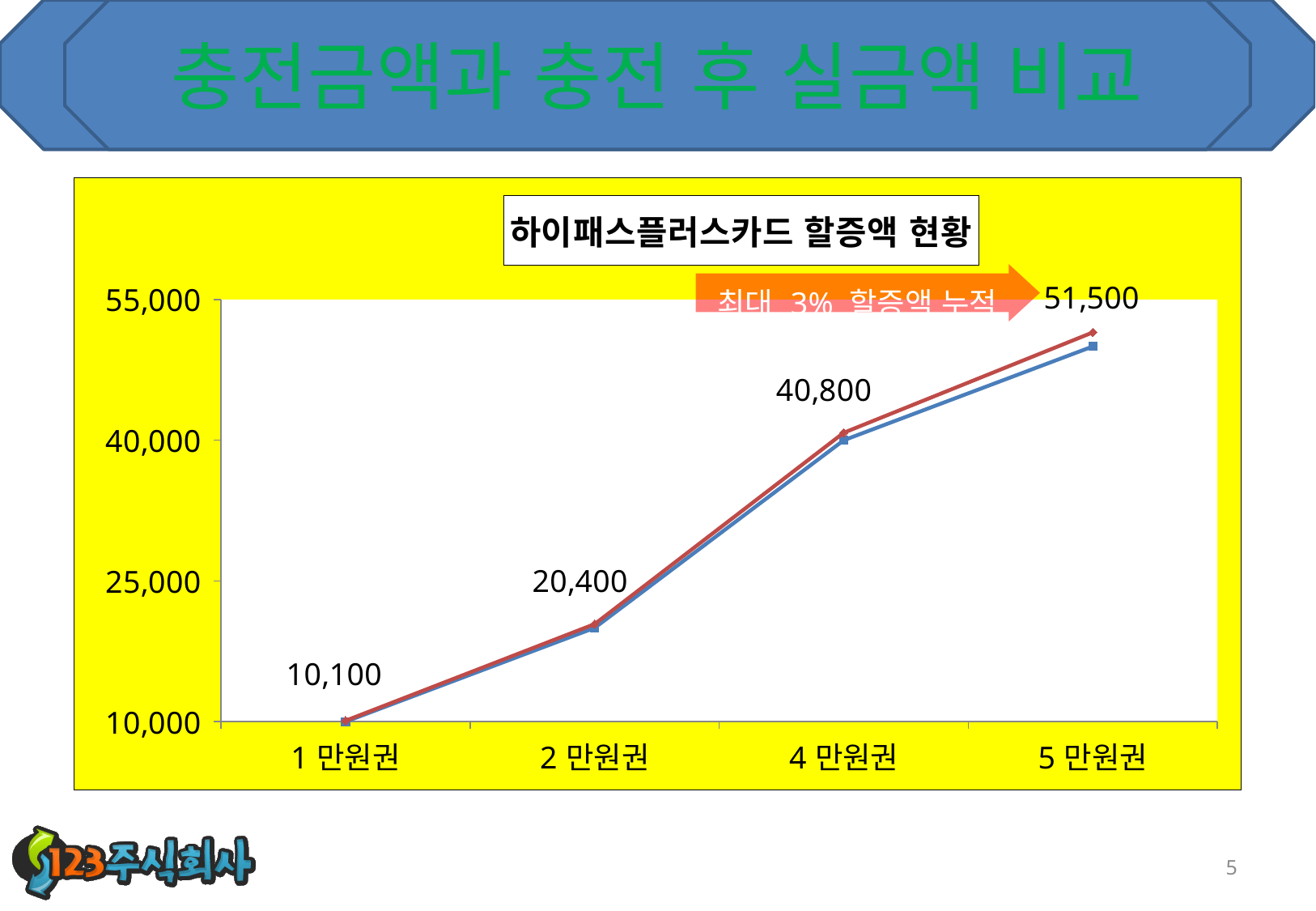
What value is labelled at 4 만원권 in the chart? 40,800 Is the value of the blue line at 5 만원권 greater or less than 55,000? less What is the title of the chart? 하이패스플러스카드 할증액 현황 Which category has the highest labelled value in the chart? 5 만원권 Which category has the lowest labelled value in the chart? 1 만원권 How many categories are shown on the x axis of the chart? 4 What value is labelled at 1 만원권 in the chart? 10,100 What value is labelled at 5 만원권 in the chart? 51,500 What is the difference between the labelled values at 5 만원권 and 4 만원권? 10,700 What kind of chart is shown on the slide? line chart What value is labelled at 2 만원권 in the chart? 20,400 Do the plotted values rise or fall from 1 만원권 to 5 만원권? rise